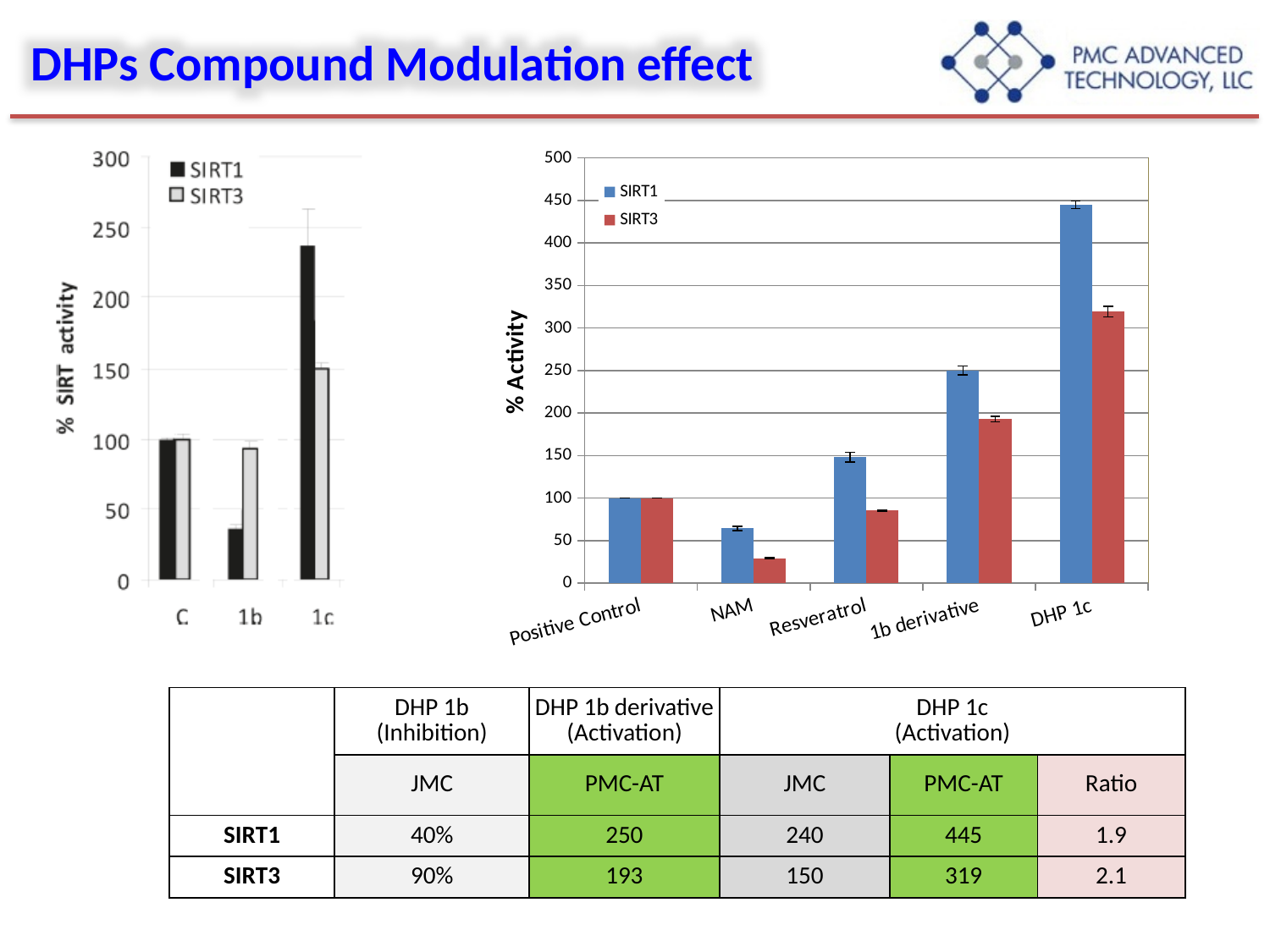
In the right-hand chart (% Activity), which category has the highest SIRT1 value? DHP 1c In the right-hand chart (% Activity), is the SIRT1 value for DHP 1c greater or less than 400? greater In the right-hand chart (% Activity), how many series does the legend list? 2 In the right-hand chart (% Activity), how many categories are shown on the x axis? 5 In the right-hand chart (% Activity), is the SIRT3 value for Resveratrol greater or less than 100? less In the right-hand chart (% Activity), for Resveratrol, which series has the larger value, SIRT1 or SIRT3? SIRT1 In the left-hand chart (% SIRT activity), how many categories are shown on the x axis? 3 In the right-hand chart (% Activity), which category has the lowest SIRT3 value? NAM In the left-hand chart (% SIRT activity), for category 1b, which series has the larger value, SIRT1 or SIRT3? SIRT3 In the right-hand chart (% Activity), what is the SIRT1 value for Positive Control? 100 In the left-hand chart (% SIRT activity), is the SIRT1 value for 1c greater or less than 200? greater What kind of chart is the right-hand chart with the y axis labelled % Activity? bar chart